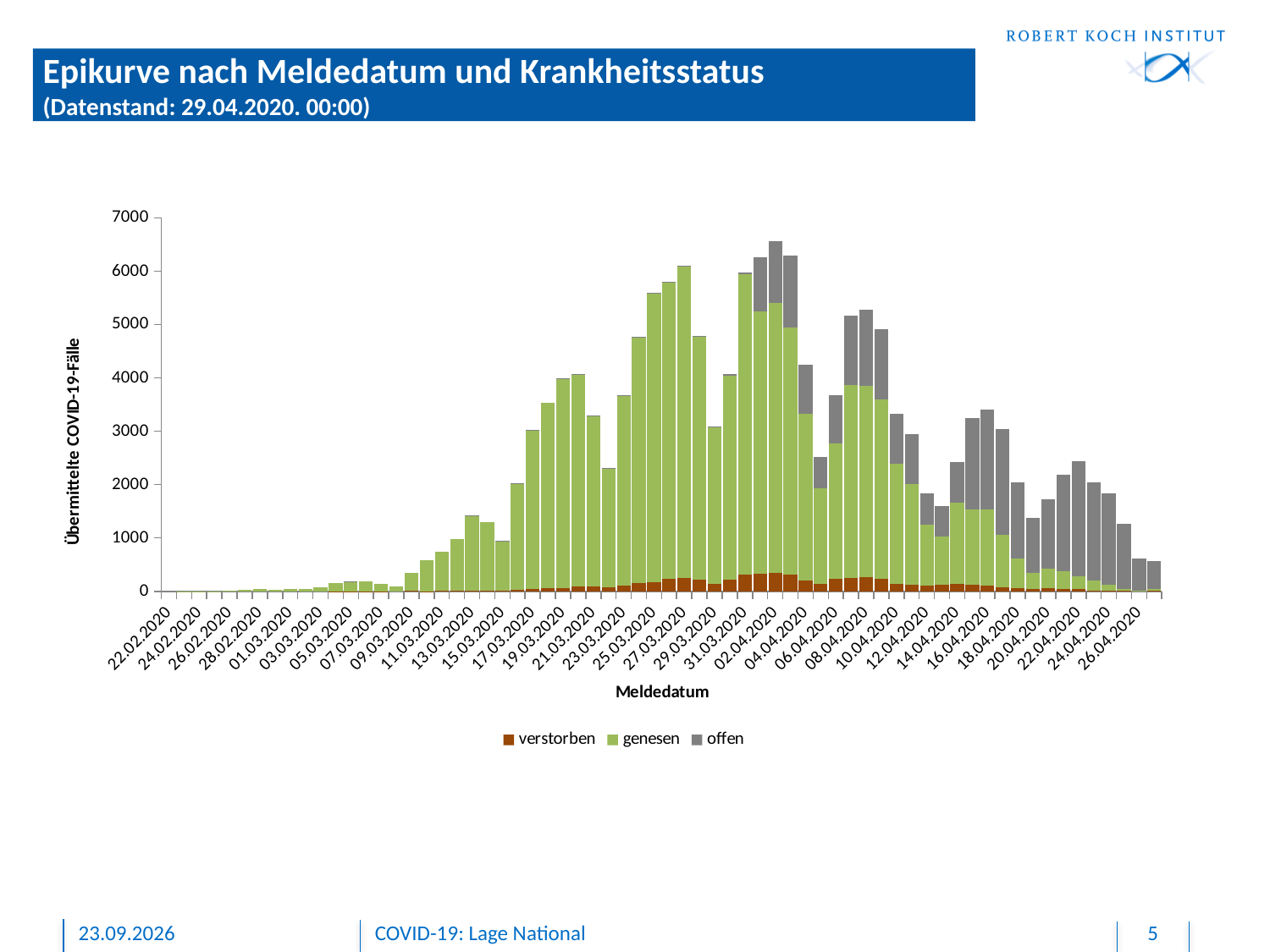
Which has the larger total, 22.02.2020 or 26.04.2020? 26.04.2020 Which has the larger total, 01.03.2020 or 11.03.2020? 11.03.2020 Is the total value for 01.03.2020 greater or less than 1000? less Is the total value for 09.03.2020 greater or less than 1000? less How many series does the legend list? 3 Do the bar totals generally rise or fall from 22.02.2020 to 02.04.2020? rise Is the total value for 26.04.2020 greater or less than 1000? less What is the label of the y axis? Übermittelte COVID-19-Fälle What kind of chart is shown on the slide? Stacked bar chart What are the three series named in the legend? verstorben, genesen, offen Do the bar totals generally rise or fall from 10.04.2020 to 26.04.2020? fall